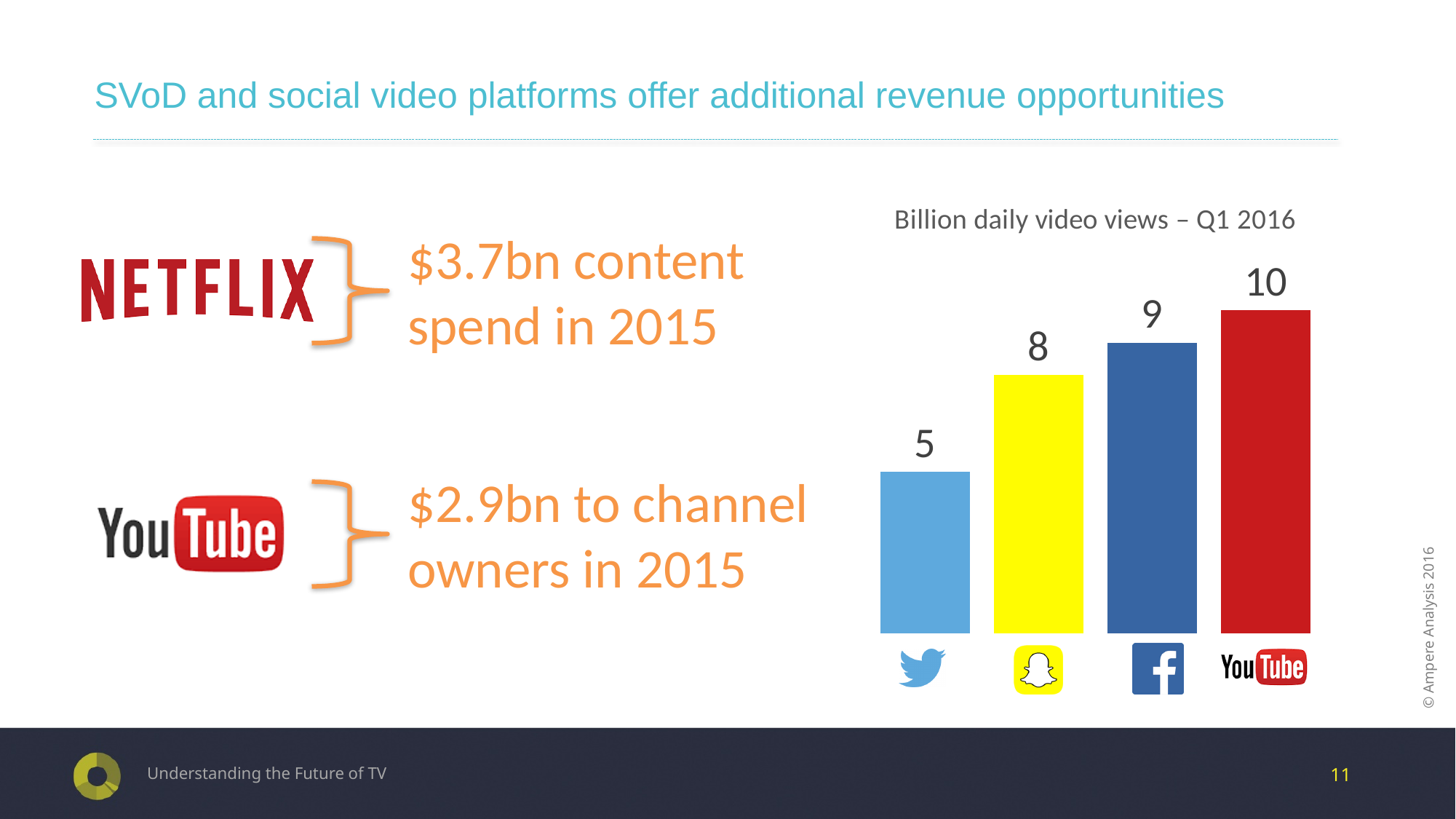
How many platforms are shown in the 'Billion daily video views – Q1 2016' chart? 4 Which platform has the lowest billion daily video views in the chart? Twitter What is the value for YouTube in the 'Billion daily video views – Q1 2016' chart? 10 What kind of chart is used to show billion daily video views? Bar chart What is the value for Snapchat in the 'Billion daily video views – Q1 2016' chart? 8 Do the values in the 'Billion daily video views – Q1 2016' chart rise or fall from left to right? Rise Which platform has the highest billion daily video views in the chart? YouTube What is the difference between Facebook's and Snapchat's billion daily video views? 1 What is the difference between YouTube's and Twitter's billion daily video views? 5 What is the value for Twitter in the 'Billion daily video views – Q1 2016' chart? 5 What is the value for Facebook in the 'Billion daily video views – Q1 2016' chart? 9 Which has more billion daily video views, Facebook or Snapchat? Facebook